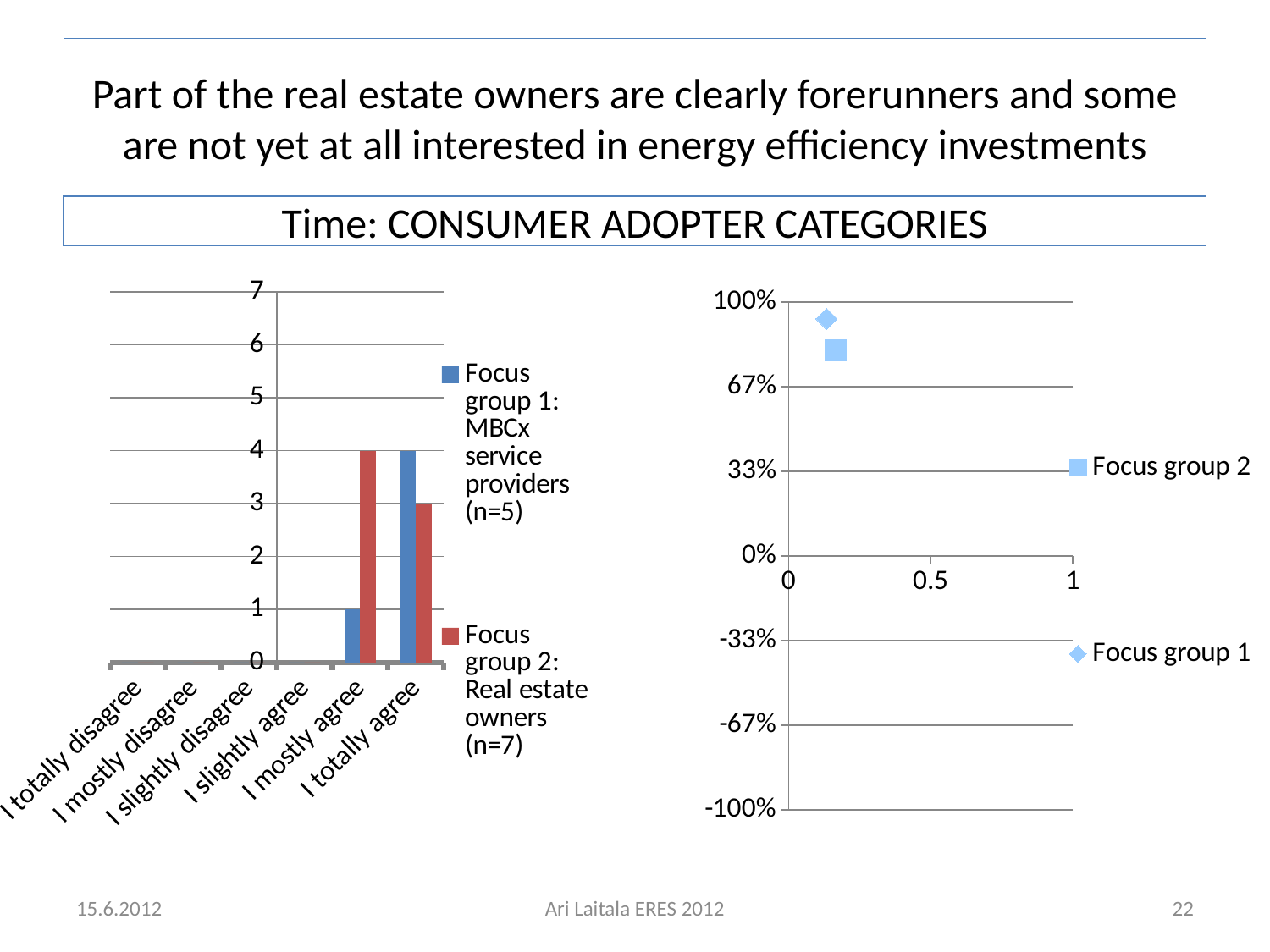
On the left chart, what is the difference between Focus group 2 and Focus group 1 in the 'I mostly agree' category? 3 On the right chart, is the y value of the Focus group 1 point greater or less than 67%? greater On the right chart, how many series does the legend list? 2 On the left chart, what is the value for Focus group 2: Real estate owners (n=7) in the 'I mostly agree' category? 4 On the left chart, what kind of chart is it? bar chart On the left chart, what is the value for Focus group 1: MBCx service providers (n=5) in the 'I mostly agree' category? 1 On the left chart, in which category does Focus group 1: MBCx service providers (n=5) have its highest value? I totally agree On the left chart, how many categories are shown on the x axis? 6 On the left chart, how many series does the legend list? 2 On the left chart, what is the value for Focus group 2: Real estate owners (n=7) in the 'I totally agree' category? 3 On the left chart, in the 'I mostly agree' category, which series has the larger value? Focus group 2: Real estate owners (n=7) On the left chart, what is the value for Focus group 1: MBCx service providers (n=5) in the 'I totally agree' category? 4